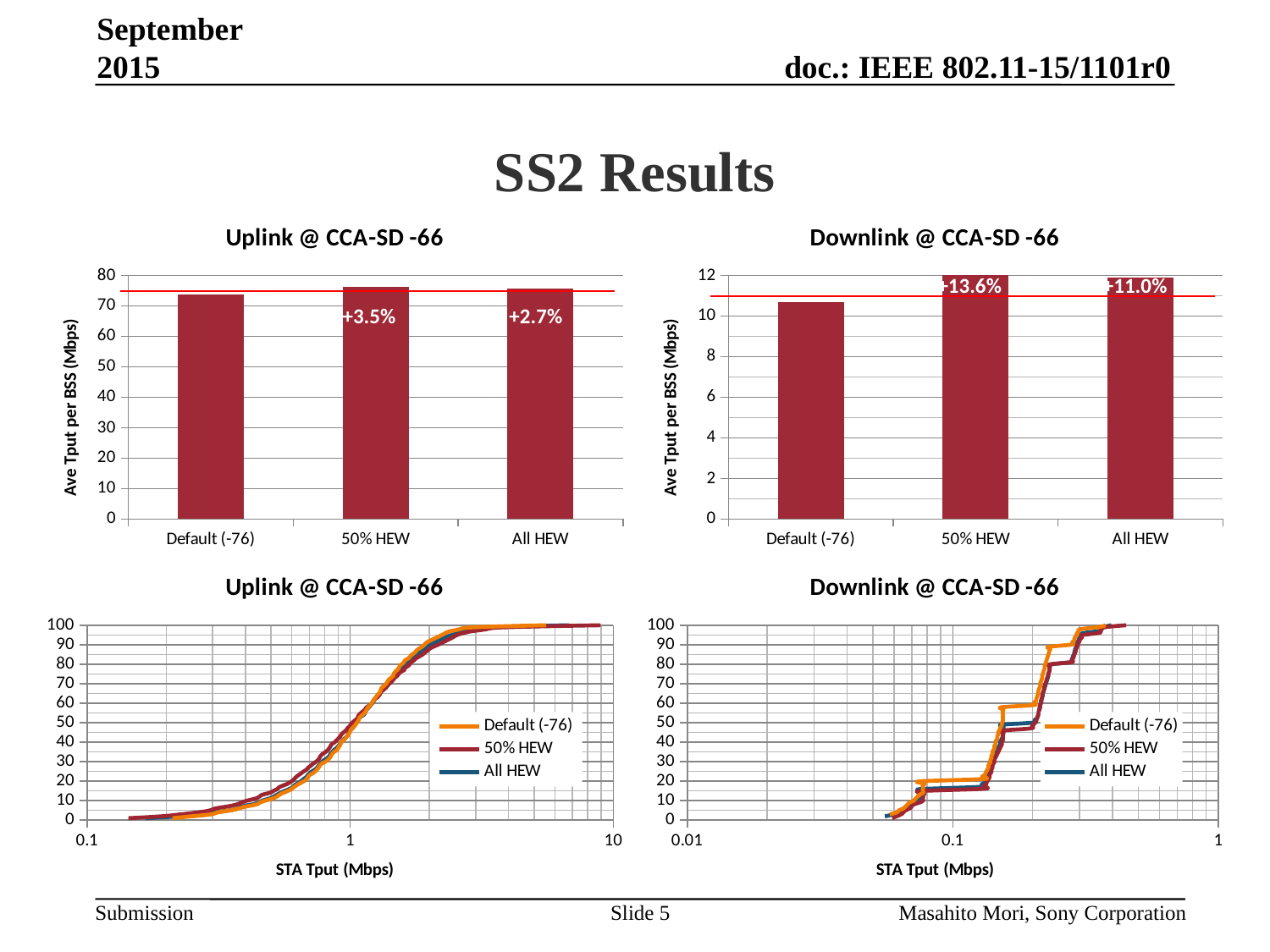
In the top-right bar chart (Downlink @ CCA-SD -66), which category has the lowest bar? Default (-76) In the top-left bar chart (Uplink @ CCA-SD -66), is the value for Default (-76) greater or less than 70? greater What is the x-axis title of the bottom-left line chart? STA Tput (Mbps) In the top-right bar chart (Downlink @ CCA-SD -66), is the value for 50% HEW greater or less than 10? greater In the top-right bar chart (Downlink @ CCA-SD -66), what percentage gain is printed on the All HEW bar? +11.0% In the bottom-right line chart (Downlink @ CCA-SD -66), do the plotted values rise or fall as STA Tput increases along the x axis? rise What kind of chart is the top-left chart titled 'Uplink @ CCA-SD -66'? bar chart What kind of chart is the bottom-right chart titled 'Downlink @ CCA-SD -66'? line chart In the top-left bar chart (Uplink @ CCA-SD -66), how many categories are shown on the x axis? 3 In the top-left bar chart (Uplink @ CCA-SD -66), what percentage gain is printed above the 50% HEW bar? +3.5% In the bottom-left line chart (Uplink @ CCA-SD -66), how many series does the legend list? 3 In the top-left bar chart (Uplink @ CCA-SD -66), which category has the lowest bar? Default (-76)